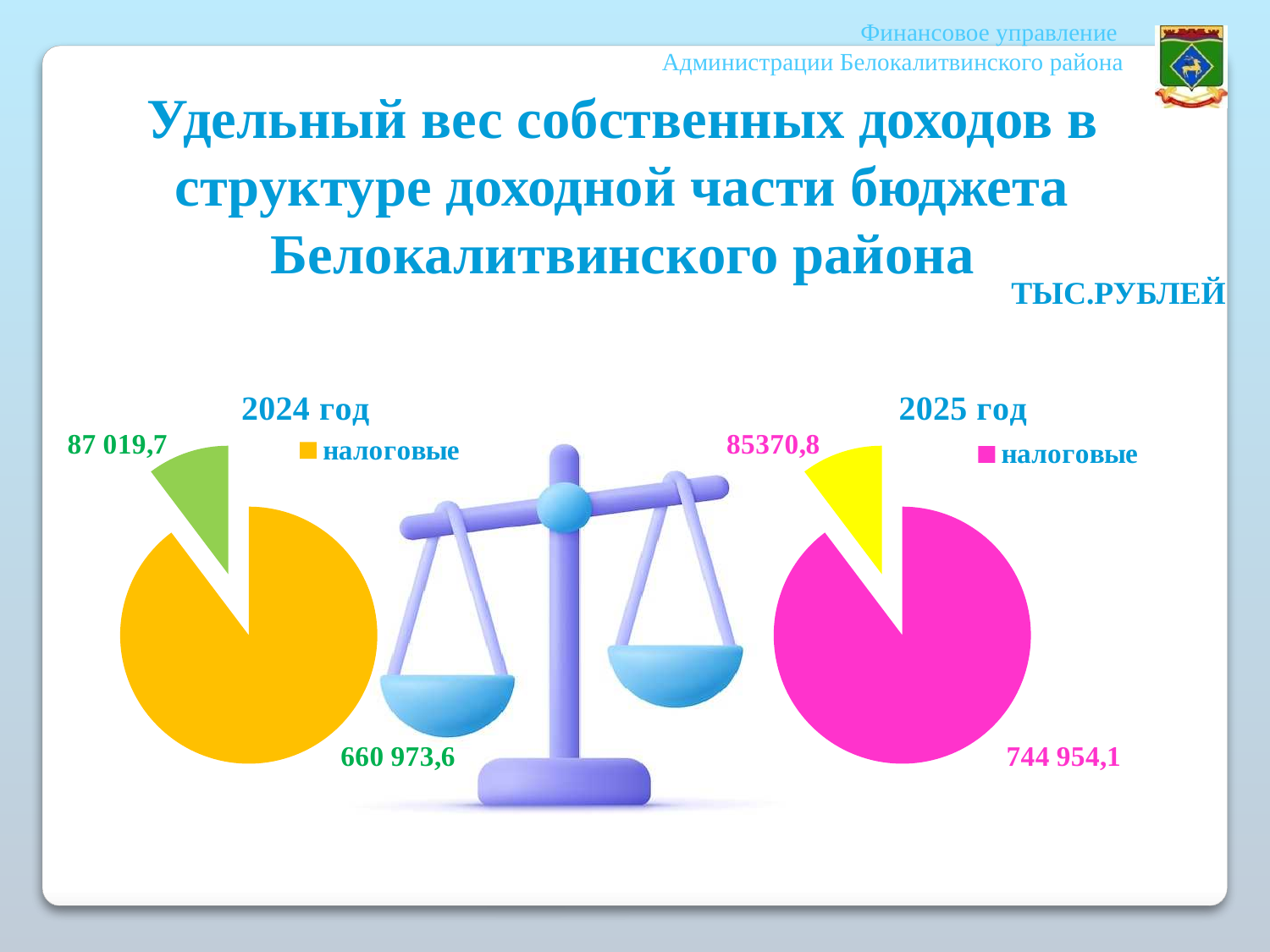
Which is larger: налоговые in the 2024 год chart or налоговые in the 2025 год chart? 2025 год In the 2024 год pie chart, what is the difference between the налоговые slice and the green slice? 573 953,9 What unit is stated for the values on the slide? ТЫС.РУБЛЕЙ In the 2024 год pie chart, which slice is the largest? налоговые In the 2025 год pie chart, what value is printed next to the small yellow slice? 85370,8 In the 2024 год pie chart, what is the value for налоговые? 660 973,6 How many entries does the legend of the 2024 год pie chart list? 1 How many slices does the 2025 год pie chart have? 2 In the 2024 год pie chart, what value is printed next to the small green slice? 87 019,7 What kind of chart is used for the 2024 год data? Pie chart What is the difference between налоговые in the 2025 год chart and налоговые in the 2024 год chart? 83 980,5 In the 2025 год pie chart, what is the value for налоговые? 744 954,1